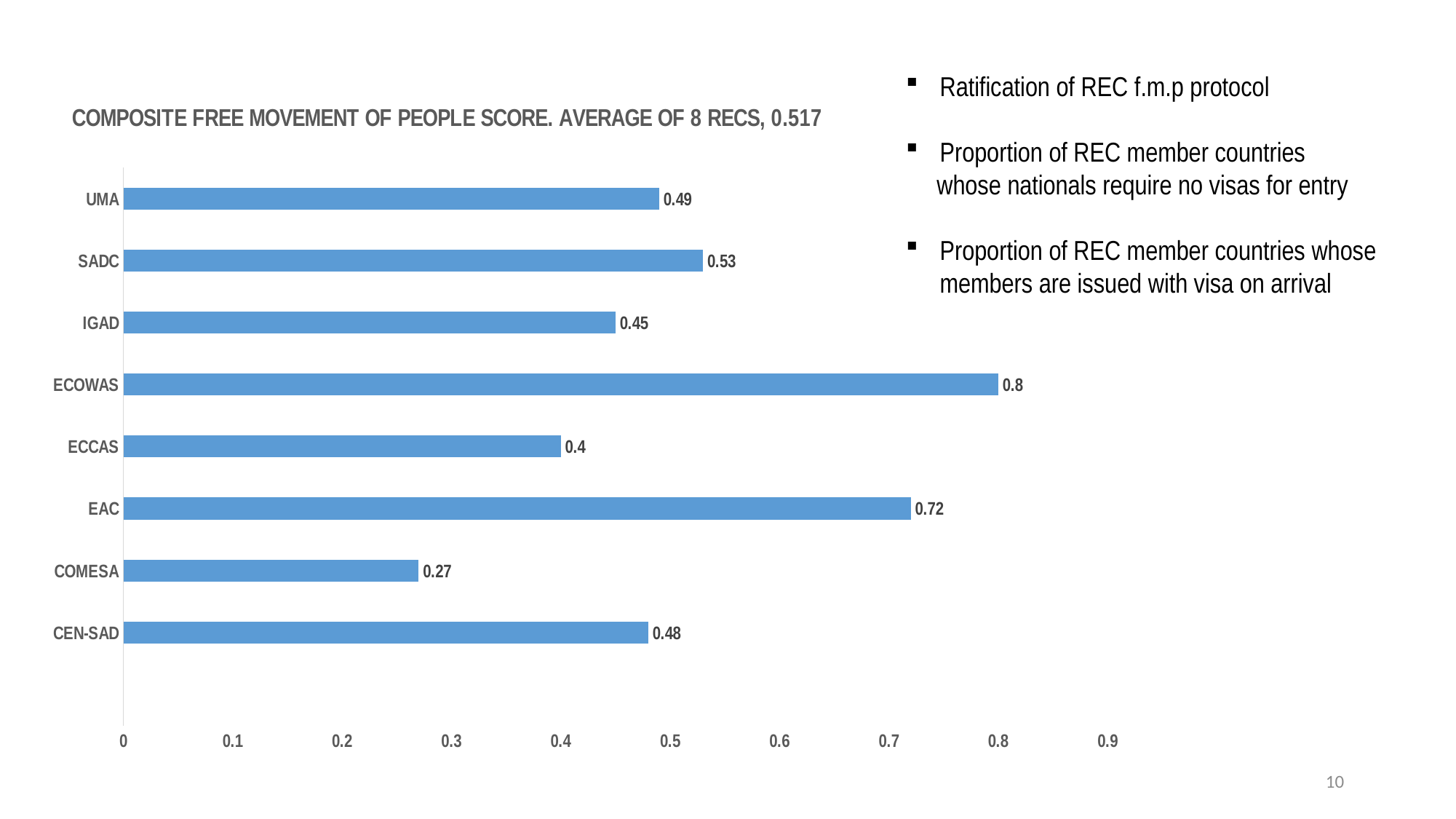
What is the score shown for COMESA? 0.27 Which REC has the lowest composite free movement of people score? COMESA What average score of the 8 RECs is stated in the chart title? 0.517 What is the score shown for EAC? 0.72 What is the difference between the scores of SADC and IGAD? 0.08 What kind of chart is shown on the slide? Bar chart Which has a higher score, EAC or SADC? EAC Is the score for CEN-SAD greater or less than 0.5? less Which REC has the highest composite free movement of people score? ECOWAS What is the composite free movement of people score for ECOWAS? 0.8 How many RECs are shown in the chart? 8 What is the difference between the scores of ECOWAS and COMESA? 0.53